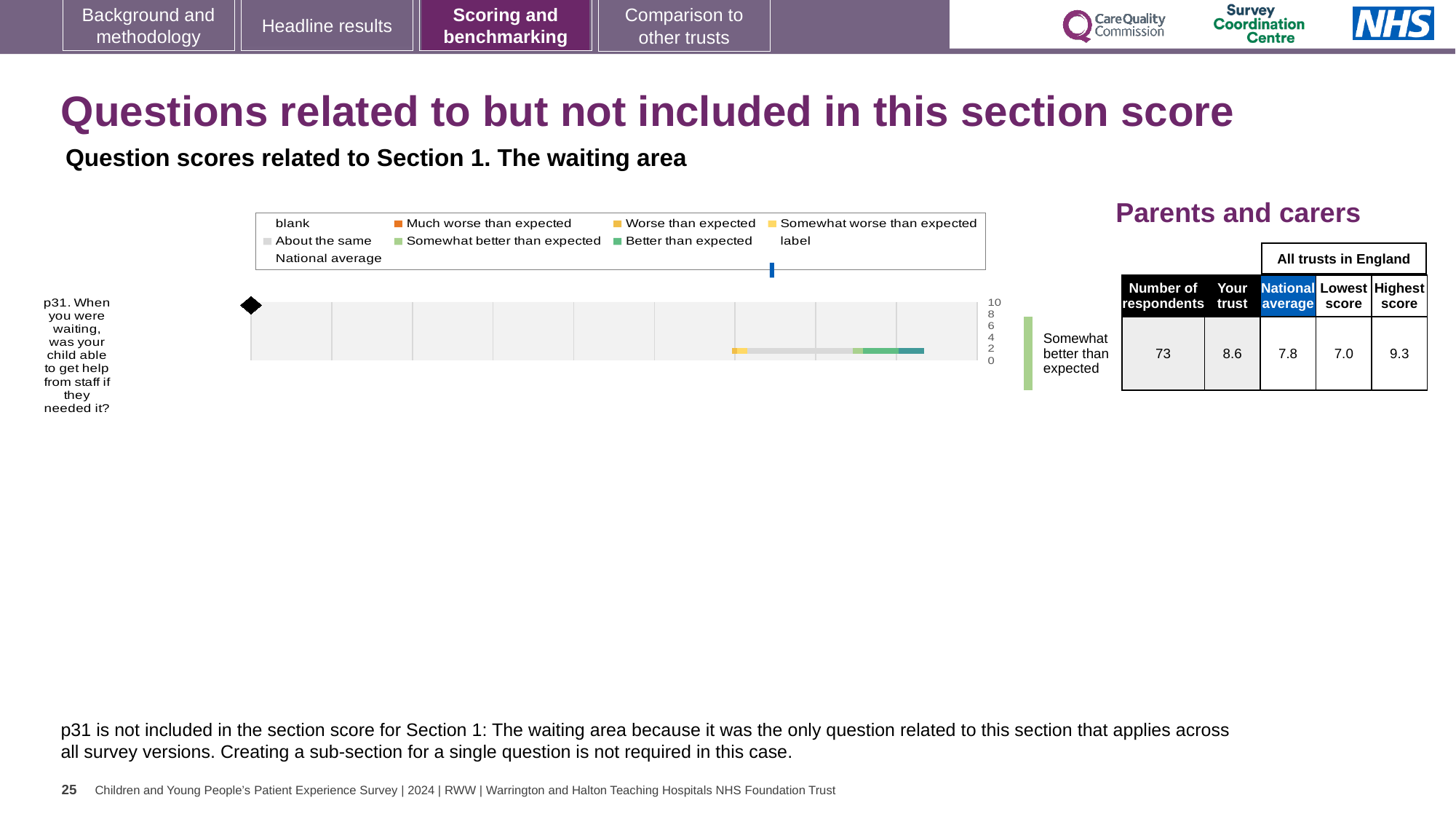
What rating label is shown next to the chart for p31? Somewhat better than expected Is the 'Your trust' score for p31 higher or lower than the National average? higher How many questions are plotted on the chart? 1 What is the difference between the 'Your trust' score and the National average for p31? 0.8 How many respondents answered p31? 73 What is the 'Your trust' score for p31 in the Parents and carers table? 8.6 What is the Lowest score among all trusts in England for p31? 7.0 What is the National average score for p31? 7.8 What kind of chart is used to show the p31 question score? bar chart What is the difference between the Highest score and the Lowest score for p31? 2.3 What is the Highest score among all trusts in England for p31? 9.3 Which question is plotted on the chart? p31. When you were waiting, was your child able to get help from staff if they needed it?